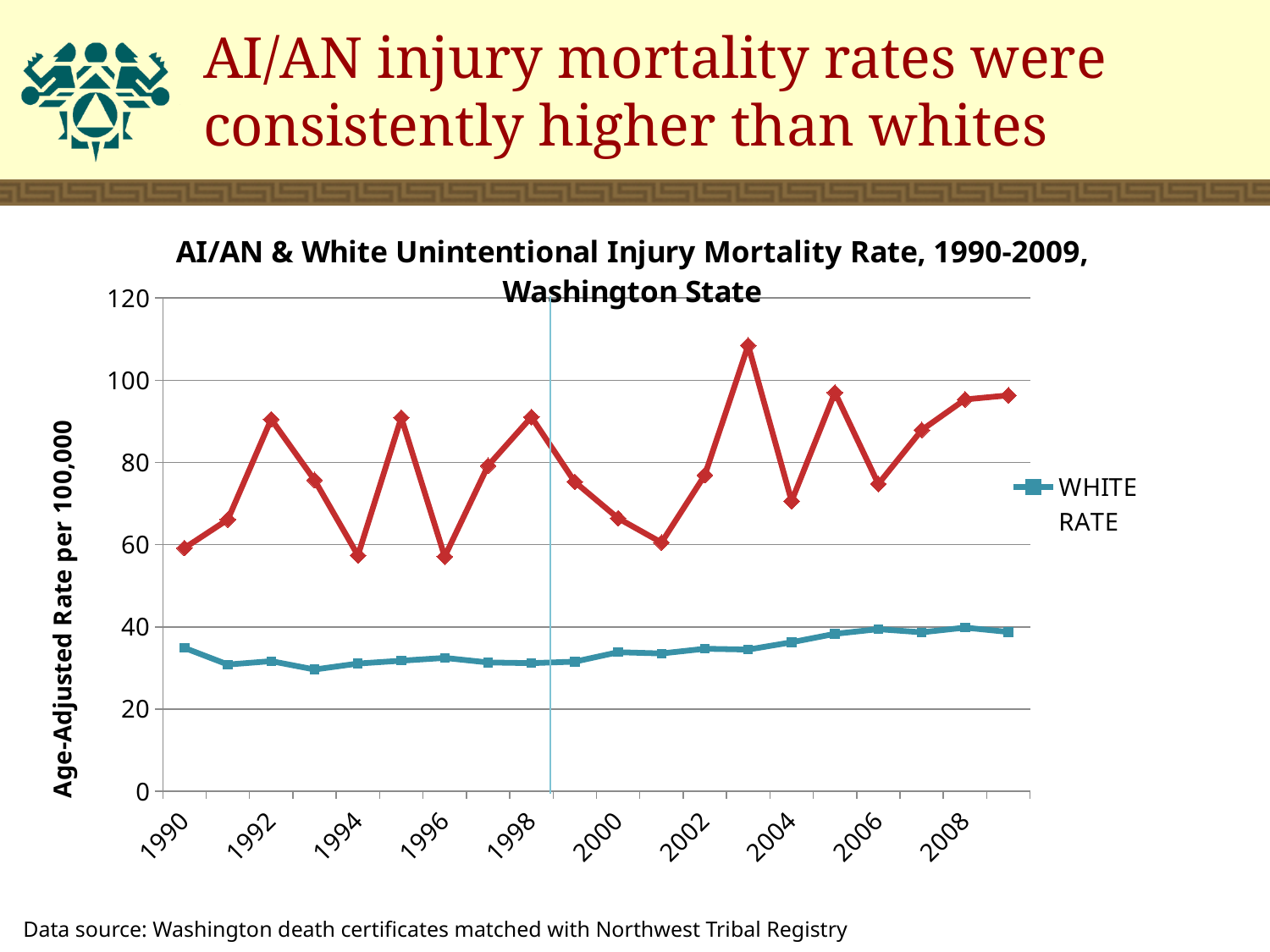
Which is larger for the red (AI/AN) line: the value in 1992 or the value in 1994? 1992 Is the WHITE RATE value in 1990 greater or less than 40? less Is the value of the red (AI/AN) line in 2003 greater or less than 100? greater Does the WHITE RATE line rise or fall between 2000 and 2006? rise What is the label on the vertical axis of the chart? Age-Adjusted Rate per 100,000 Which is larger in 2005: the red (AI/AN) line or the WHITE RATE line? the red (AI/AN) line In which year does the red (AI/AN) line reach its highest value? 2003 Is the value of the red (AI/AN) line in 1992 greater or less than 80? greater What kind of chart is shown on the slide? line chart How many series does the chart's legend list? 1 What is the title of the chart? AI/AN & White Unintentional Injury Mortality Rate, 1990-2009, Washington State